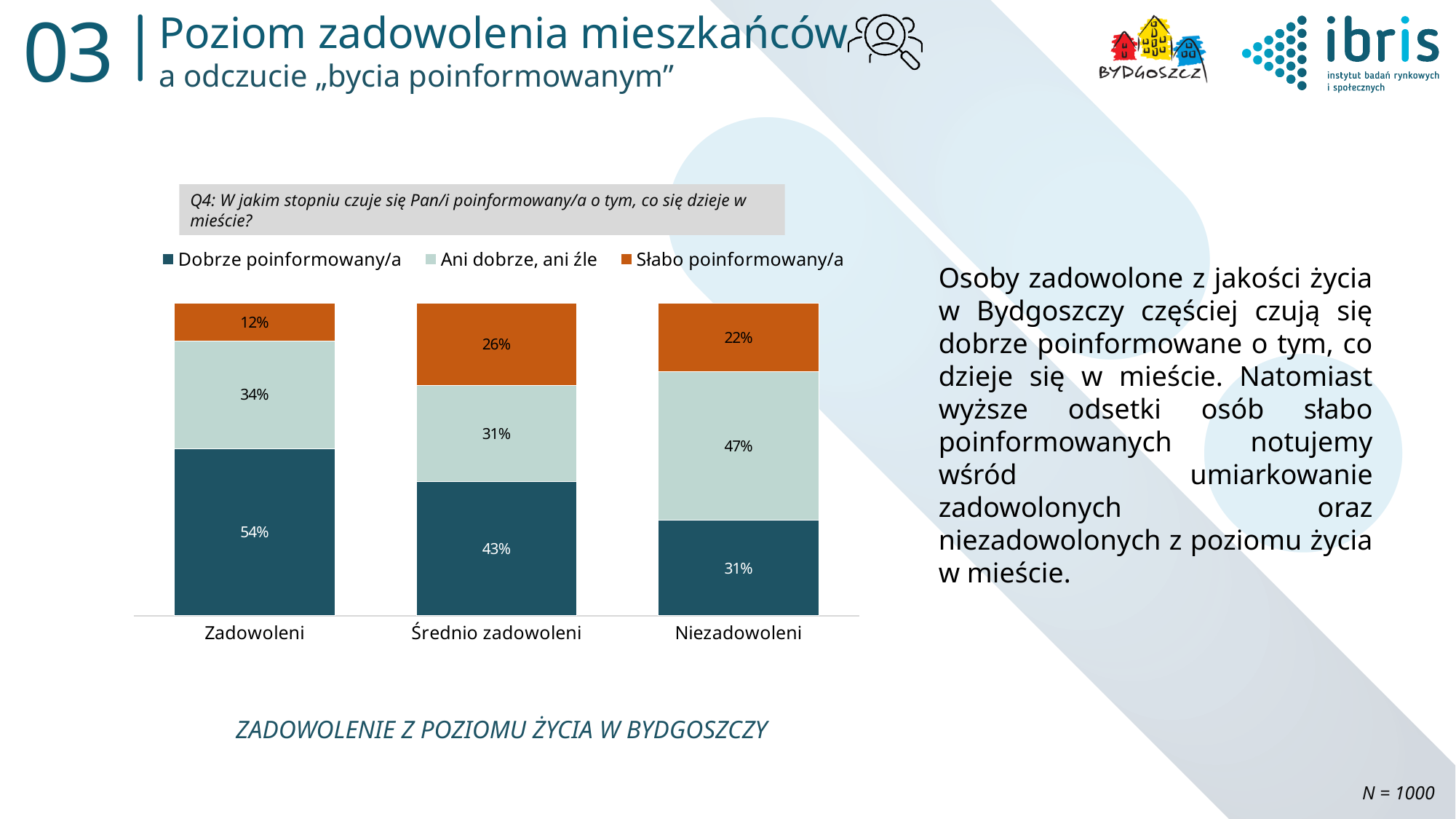
What percentage of the 'Średnio zadowoleni' group is 'Ani dobrze, ani źle'? 31% Does the 'Dobrze poinformowany/a' share rise or fall from 'Zadowoleni' to 'Niezadowoleni'? Fall What kind of chart is shown on the slide? Stacked bar chart What percentage of the 'Niezadowoleni' group is 'Słabo poinformowany/a'? 22% What percentage of the 'Zadowoleni' group is 'Dobrze poinformowany/a'? 54% What is the total of the stacked bar for 'Średnio zadowoleni'? 100% What is the difference between the 'Dobrze poinformowany/a' share for 'Zadowoleni' and for 'Niezadowoleni'? 23 percentage points Which category has the lowest share of 'Słabo poinformowany/a'? Zadowoleni Which is larger: the 'Ani dobrze, ani źle' share for 'Niezadowoleni' or for 'Zadowoleni'? Niezadowoleni How many series does the legend list? 3 How many categories are shown on the x axis? 3 Which category has the highest share of 'Dobrze poinformowany/a'? Zadowoleni